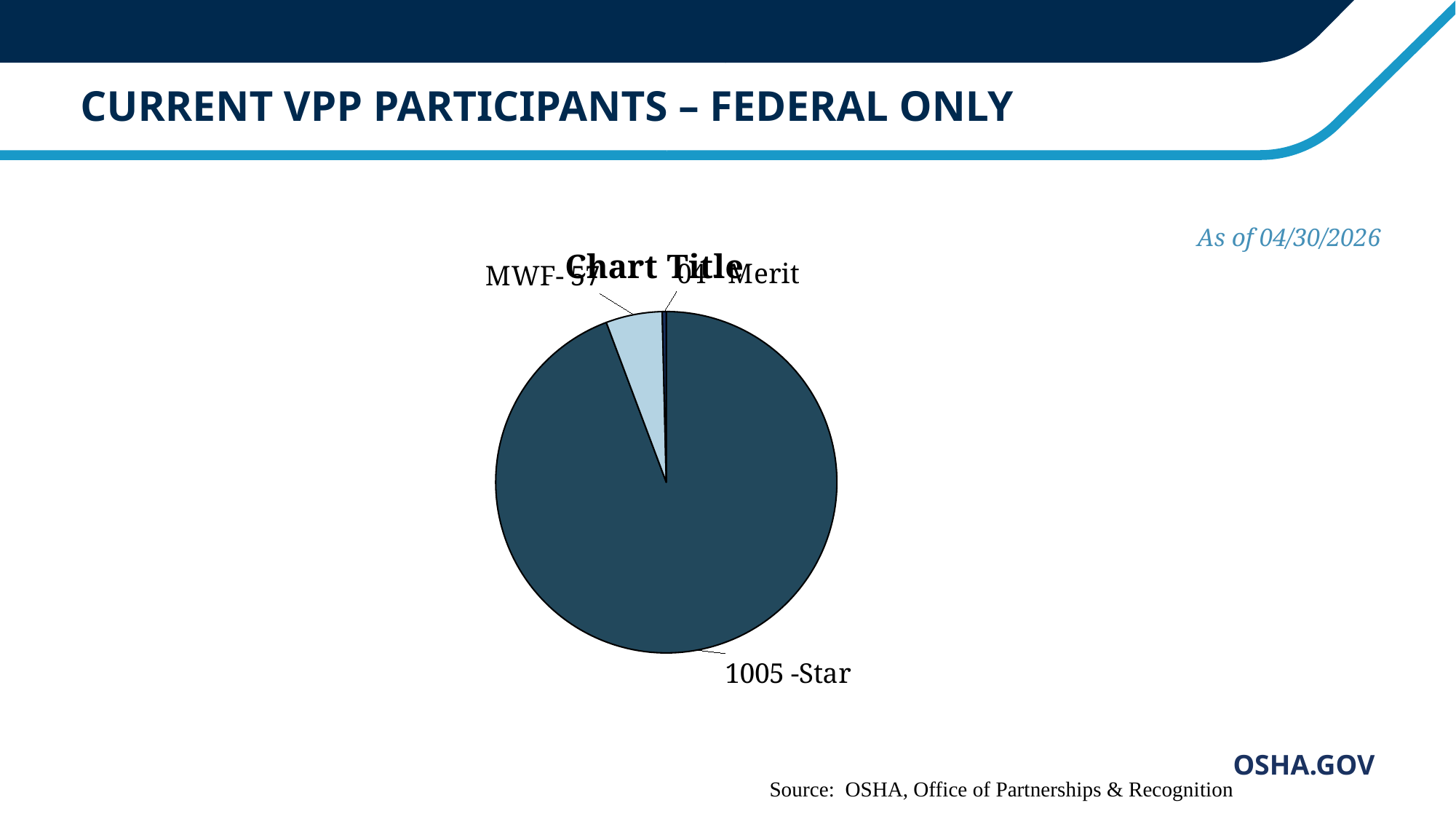
How many participants are in the MWF category? 57 Which category has the largest slice of the pie chart? Star Which category has the smallest slice of the pie chart? Merit How many slices does the pie chart have? 3 What title is printed above the pie chart? Chart Title What is the difference between the Star value and the MWF value? 948 What kind of chart is shown on the slide? pie chart What is the 'as of' date shown on the slide? 04/30/2026 Which is larger, the Star slice or the MWF slice? Star How many participants are in the Star category? 1005